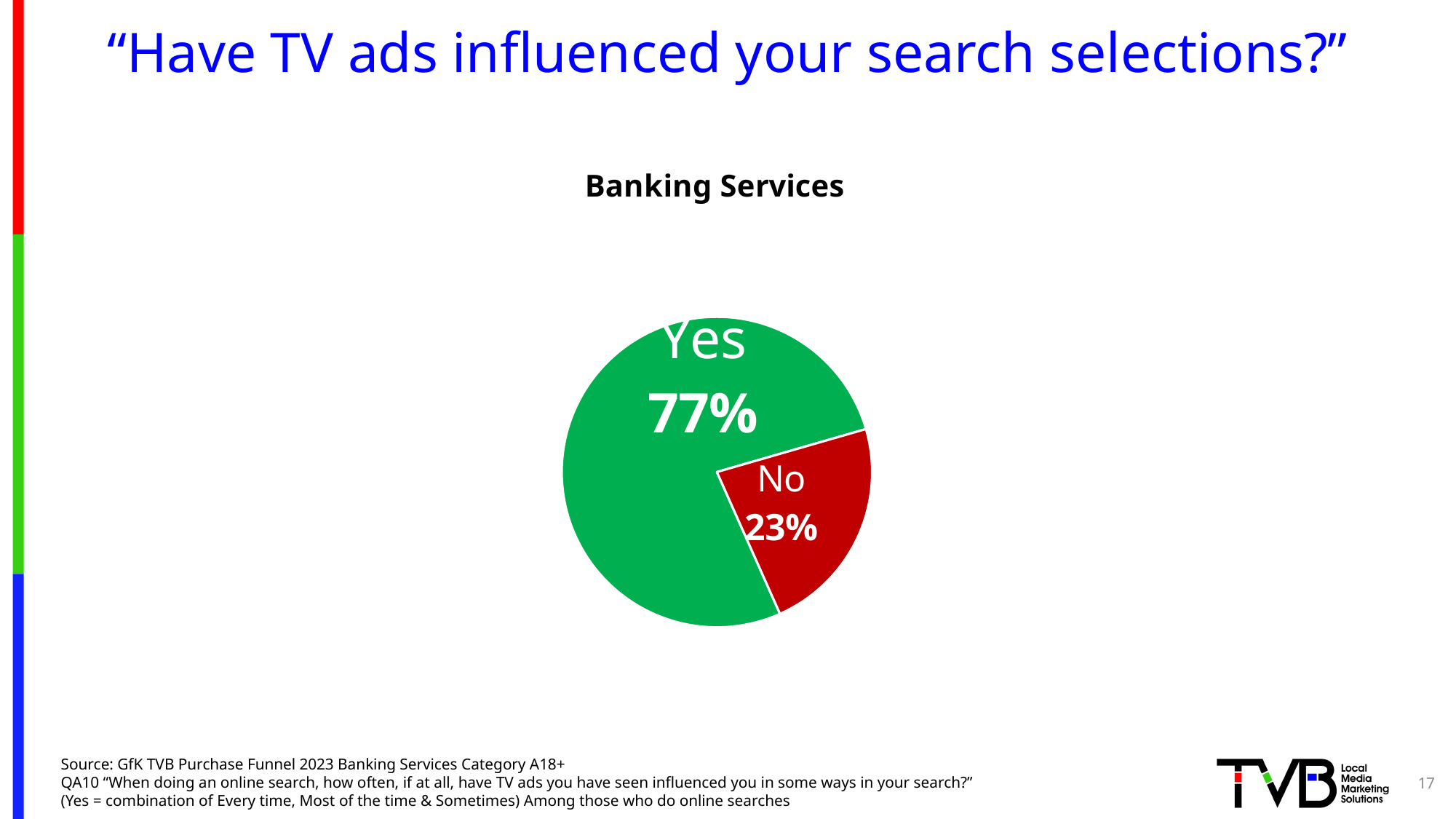
What kind of chart is shown on the slide? pie chart What share of the pie does the No slice represent? 23% How many slices does the pie chart have? 2 Which slice of the pie chart is the largest? Yes What is the value for No in the Banking Services pie chart? 23% What is the value for Yes in the Banking Services pie chart? 77% What is the difference between the Yes and No values in the pie chart? 54% Which is larger in the pie chart, Yes or No? Yes What is the title of the pie chart? Banking Services What colour is the Yes slice of the pie chart? green Which slice of the pie chart is the smallest? No